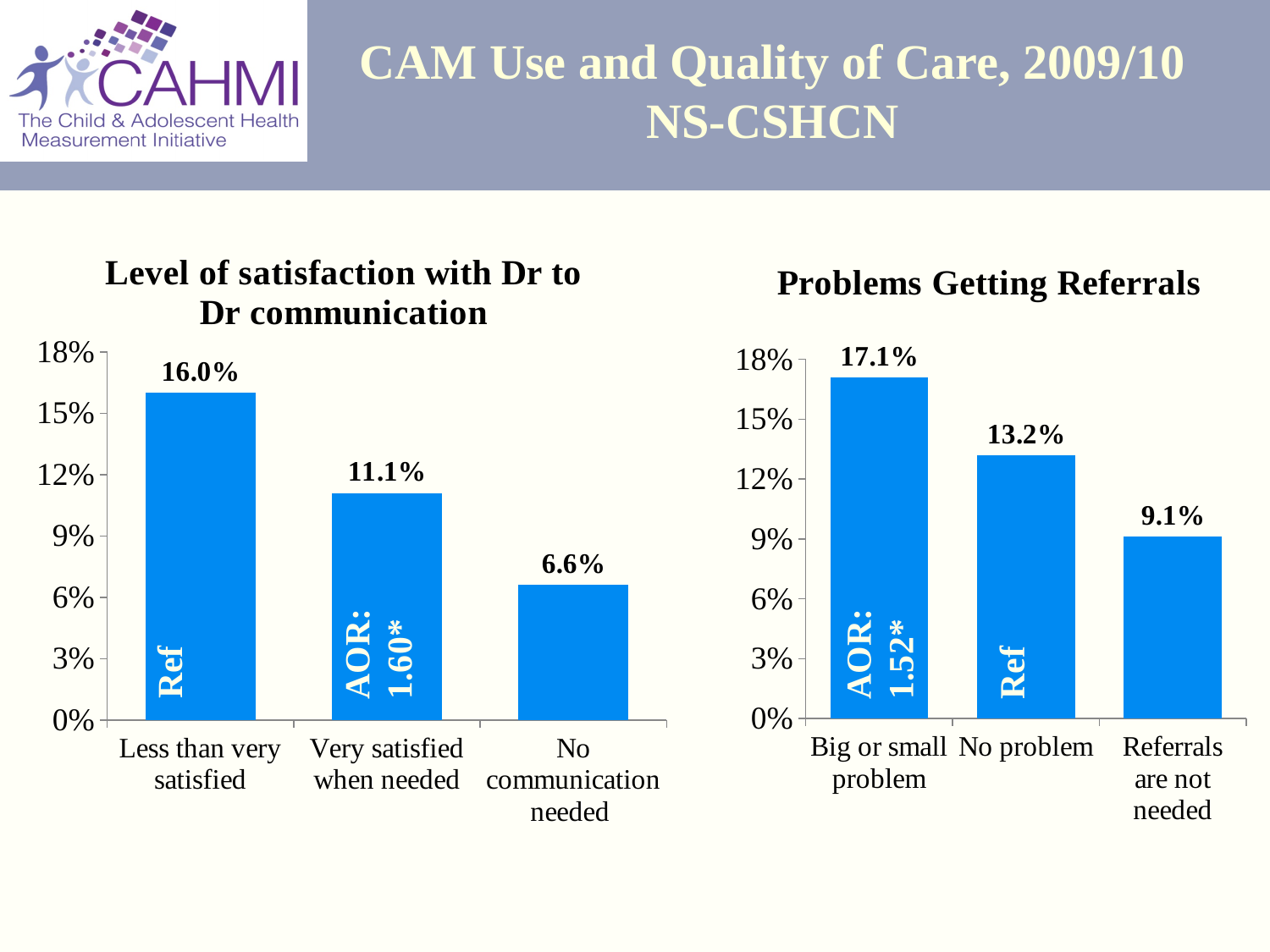
In the 'Level of satisfaction with Dr to Dr communication' chart, what is the value for 'No communication needed'? 6.6% In the 'Problems Getting Referrals' chart, which category has the highest value? Big or small problem In the 'Level of satisfaction with Dr to Dr communication' chart, what is the value for 'Less than very satisfied'? 16.0% In the 'Problems Getting Referrals' chart, which is larger: 'No problem' or 'Referrals are not needed'? No problem In the 'Problems Getting Referrals' chart, what is the value for 'No problem'? 13.2% In the 'Level of satisfaction with Dr to Dr communication' chart, what is the difference between 'Less than very satisfied' and 'Very satisfied when needed'? 4.9% In the 'Problems Getting Referrals' chart, what is the difference between 'Big or small problem' and 'Referrals are not needed'? 8.0% In the 'Problems Getting Referrals' chart, what AOR label is printed on the 'Big or small problem' bar? AOR: 1.52* What kind of chart is the 'Level of satisfaction with Dr to Dr communication' chart? bar chart In the 'Level of satisfaction with Dr to Dr communication' chart, is the value for 'Very satisfied when needed' greater or less than 12%? less In the 'Level of satisfaction with Dr to Dr communication' chart, which category has the lowest value? No communication needed How many categories are shown in the 'Problems Getting Referrals' chart? 3